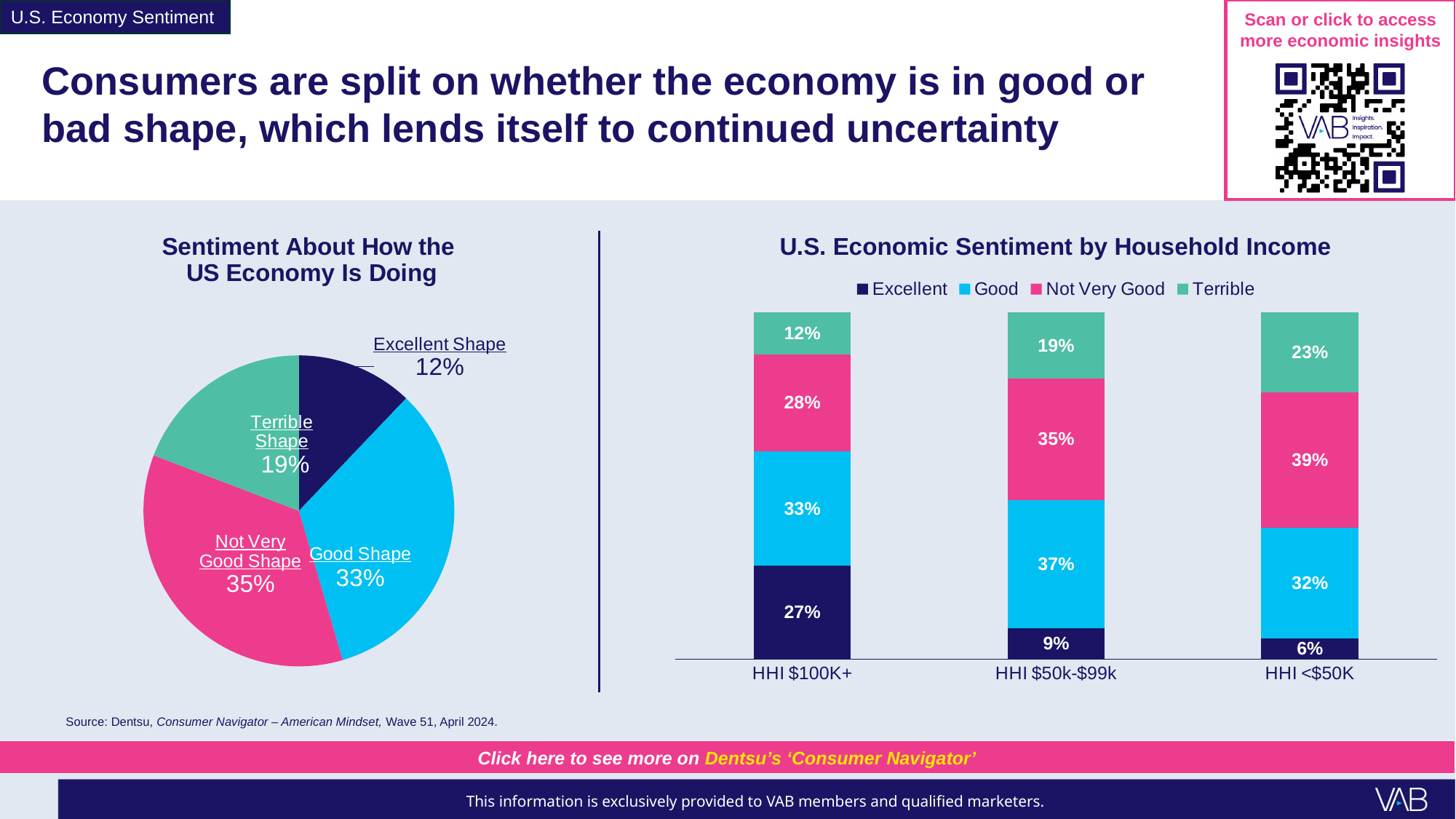
In the 'Sentiment About How the US Economy Is Doing' chart, what share of consumers say the economy is in Good Shape? 33% In the 'U.S. Economic Sentiment by Household Income' chart, does the Excellent value rise or fall moving from HHI $100K+ to HHI <$50K? Fall In the 'Sentiment About How the US Economy Is Doing' chart, which category has the smallest share? Excellent Shape In the 'U.S. Economic Sentiment by Household Income' chart, which income group has the highest Not Very Good value? HHI <$50K In the 'U.S. Economic Sentiment by Household Income' chart, what is the difference between the Excellent values for HHI $100K+ and HHI <$50K? 21% What kind of chart is 'Sentiment About How the US Economy Is Doing'? Pie chart In the 'U.S. Economic Sentiment by Household Income' chart, which is larger: the Good value for HHI $50k-$99k or the Good value for HHI <$50K? HHI $50k-$99k In the 'U.S. Economic Sentiment by Household Income' chart, what is the Terrible value for HHI <$50K? 23% In the 'U.S. Economic Sentiment by Household Income' chart, what is the Excellent value for HHI $100K+? 27% In the 'U.S. Economic Sentiment by Household Income' chart, how many series does the legend list? 4 In the 'Sentiment About How the US Economy Is Doing' chart, which category has the largest share? Not Very Good Shape In the 'Sentiment About How the US Economy Is Doing' chart, how many slices does the pie have? 4